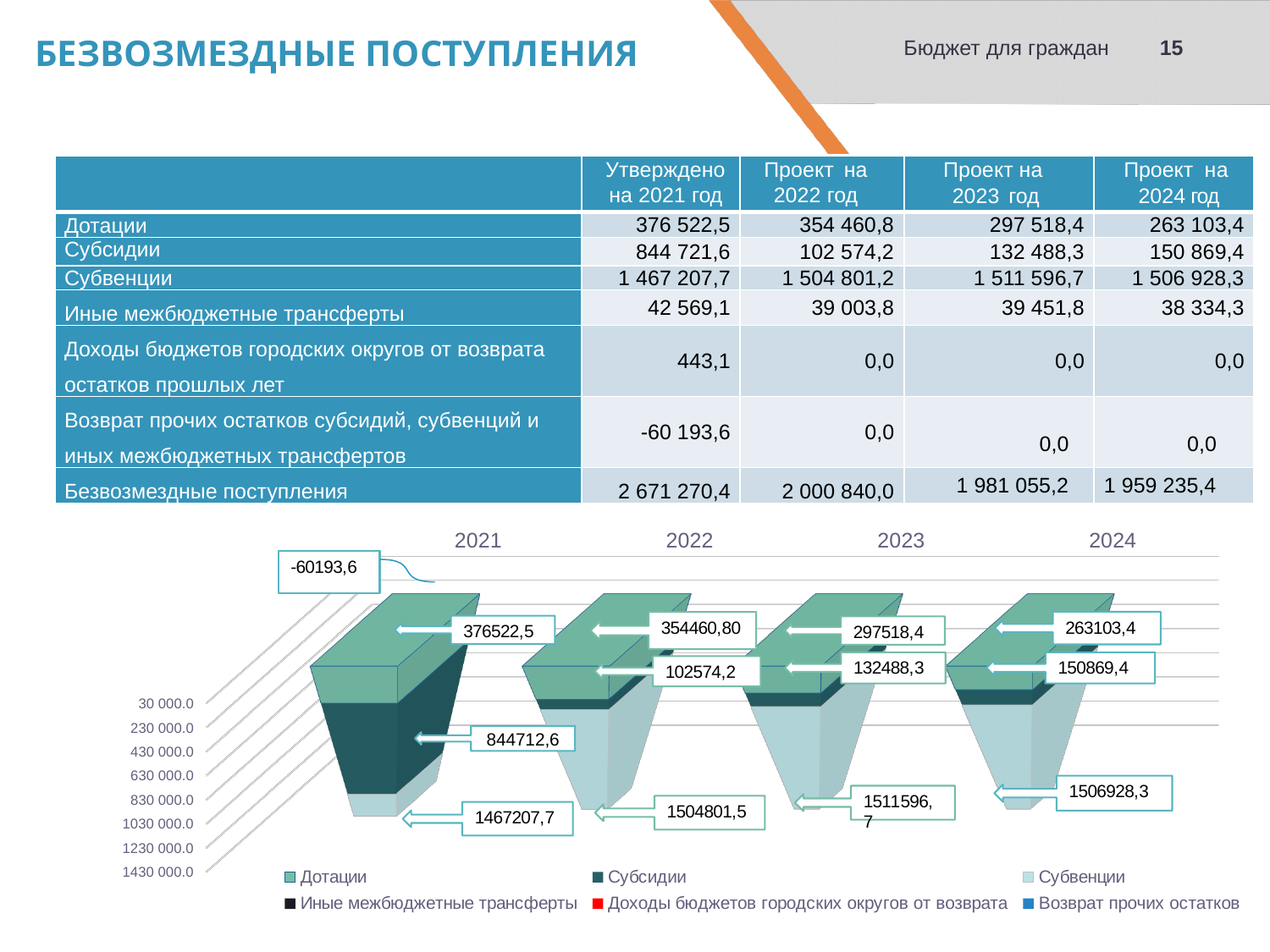
What is the data label for Субвенции in 2023 on the chart? 1511596,7 Which is larger on the chart: Субсидии in 2023 or Субсидии in 2024? Субсидии in 2024 How many series does the chart legend list? 6 How many years are shown along the x axis of the chart? 4 What is the difference between the Дотации labels for 2021 and 2022 on the chart? 22061,7 What is the data label for Субсидии in 2022 on the chart? 102574,2 What is the data label for Дотации in 2021 on the chart? 376522,5 In which year is the Дотации value on the chart the lowest? 2024 In which year is the Дотации value on the chart the highest? 2021 What is the data label for Субвенции in 2024 on the chart? 1506928,3 What kind of chart is shown on the slide? Stacked bar chart What negative value is labelled on the chart for 2021? -60193,6